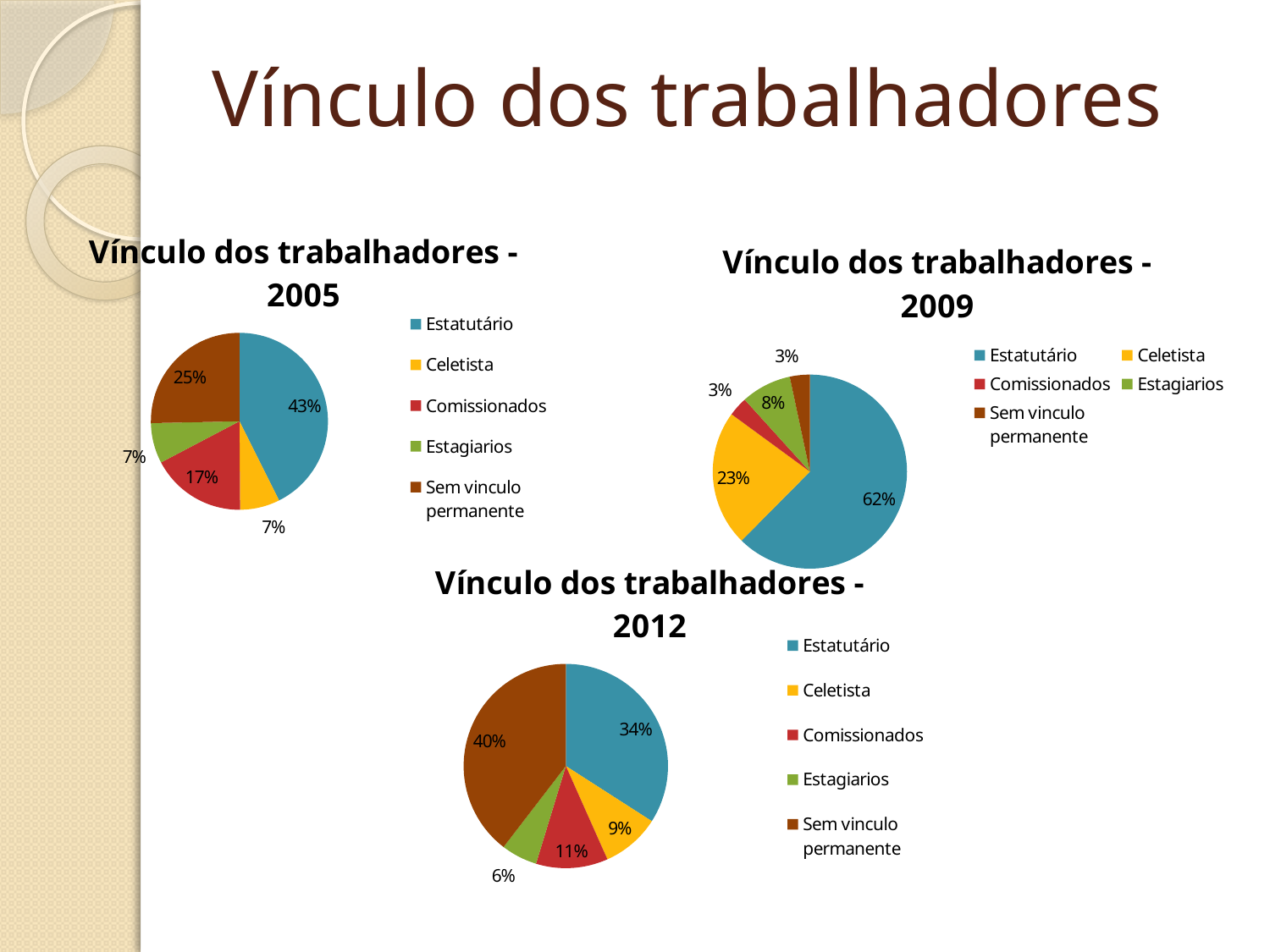
In the 'Vínculo dos trabalhadores - 2012' chart, what share is Comissionados? 11% In the 'Vínculo dos trabalhadores - 2012' chart, which category has the smallest share? Estagiarios In the 'Vínculo dos trabalhadores - 2005' chart, what share is Estatutário? 43% In the 'Vínculo dos trabalhadores - 2009' chart, which category has the largest share? Estatutário In the 'Vínculo dos trabalhadores - 2012' chart, what share is Sem vinculo permanente? 40% In the 'Vínculo dos trabalhadores - 2009' chart, what share is Celetista? 23% What type of chart is 'Vínculo dos trabalhadores - 2009'? Pie chart In the 'Vínculo dos trabalhadores - 2012' chart, which category has the largest share? Sem vinculo permanente In the 'Vínculo dos trabalhadores - 2005' chart, what share is Sem vinculo permanente? 25% In the 'Vínculo dos trabalhadores - 2009' chart, what share is Estatutário? 62% In the 'Vínculo dos trabalhadores - 2005' chart, what is the difference between the Estatutário share and the Comissionados share? 26% In the 'Vínculo dos trabalhadores - 2012' chart, which is larger, Celetista or Comissionados? Comissionados